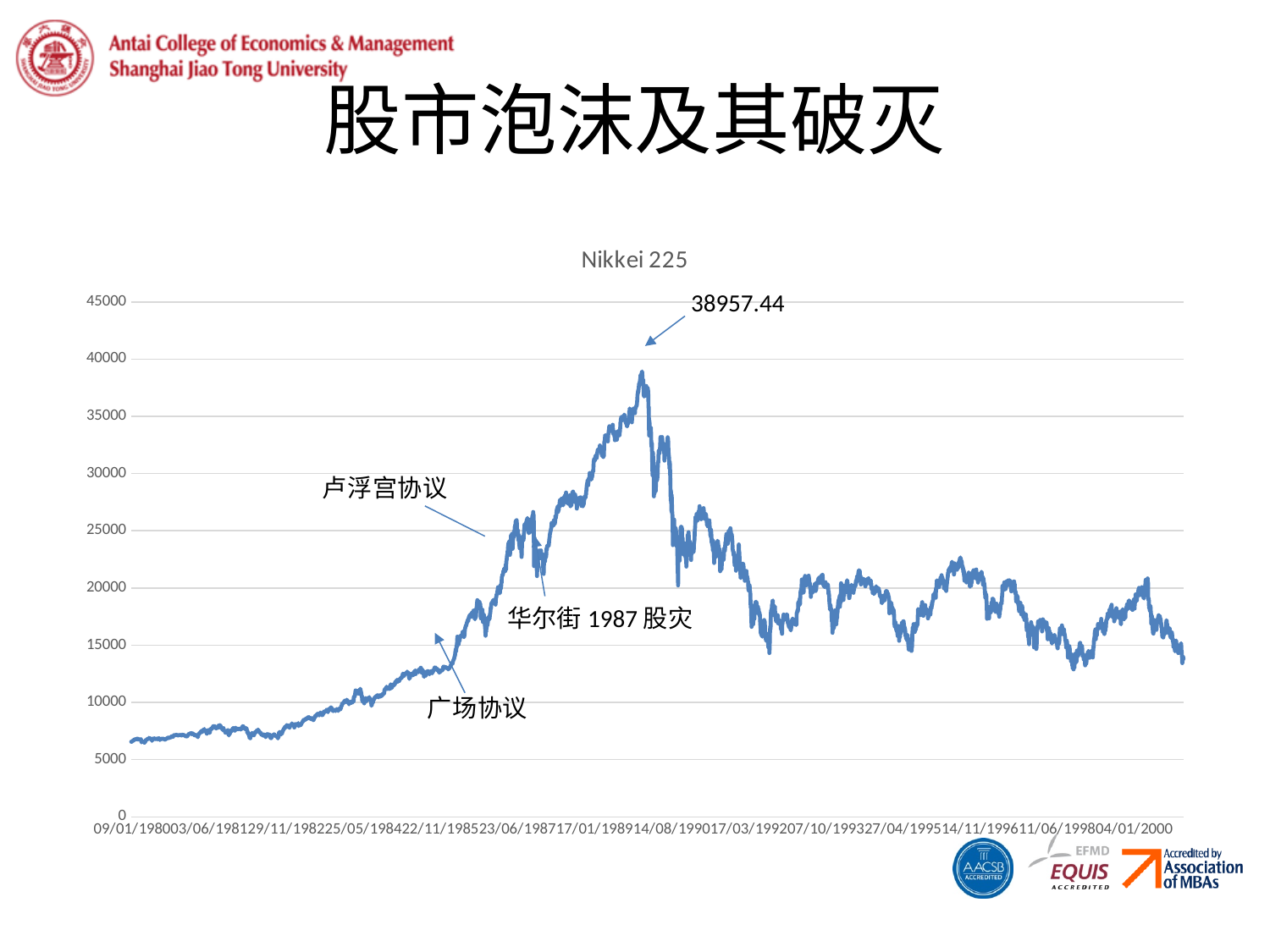
Is the Nikkei 225 value at the end of the series (04/01/2000) greater or less than 20000? less Is the peak value of the Nikkei 225 greater or less than 40000? less Is the Nikkei 225 value at the end of the series (04/01/2000) greater or less than 10000? greater What is the highest value shown on the vertical axis of the chart? 45000 Does the Nikkei 225 rise or fall between 09/01/1980 and its labelled peak? rise What is the title of the chart? Nikkei 225 What is the peak value labelled on the Nikkei 225 chart? 38957.44 Does the Nikkei 225 rise or fall from its labelled peak to the end of the series in 2000? fall What kind of chart is shown on the slide? line chart Which is larger, the Nikkei 225 value at the start of the series in 1980 or at the end of the series in 2000? the end of the series in 2000